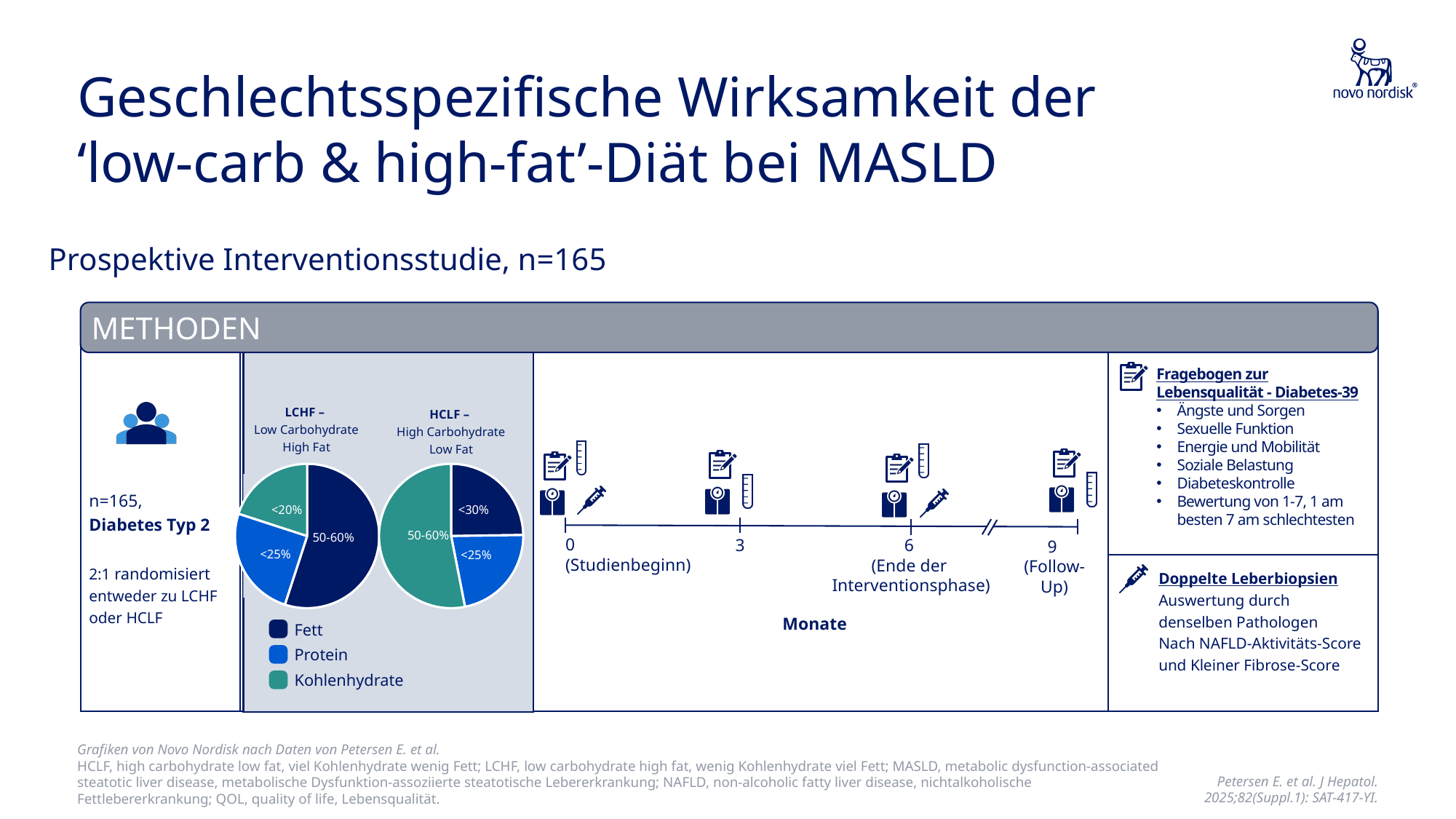
In the LCHF pie chart, which component has the largest slice? Fett In the LCHF pie chart, what share is labelled for Protein? <25% In the LCHF pie chart, what share is labelled for Kohlenhydrate? <20% What type of chart is used to show the LCHF and HCLF diet compositions? Pie chart In the HCLF pie chart, what share is labelled for Kohlenhydrate? 50-60% In the HCLF pie chart, what share is labelled for Fett? <30% In the LCHF pie chart, what share is labelled for Fett? 50-60% How many slices does the HCLF pie chart have? 3 In the HCLF pie chart, which component has the largest slice? Kohlenhydrate How many entries does the legend below the pie charts list? 3 In the LCHF pie chart, which component has the smallest slice? Kohlenhydrate Is the Fett slice larger in the LCHF pie chart or in the HCLF pie chart? LCHF